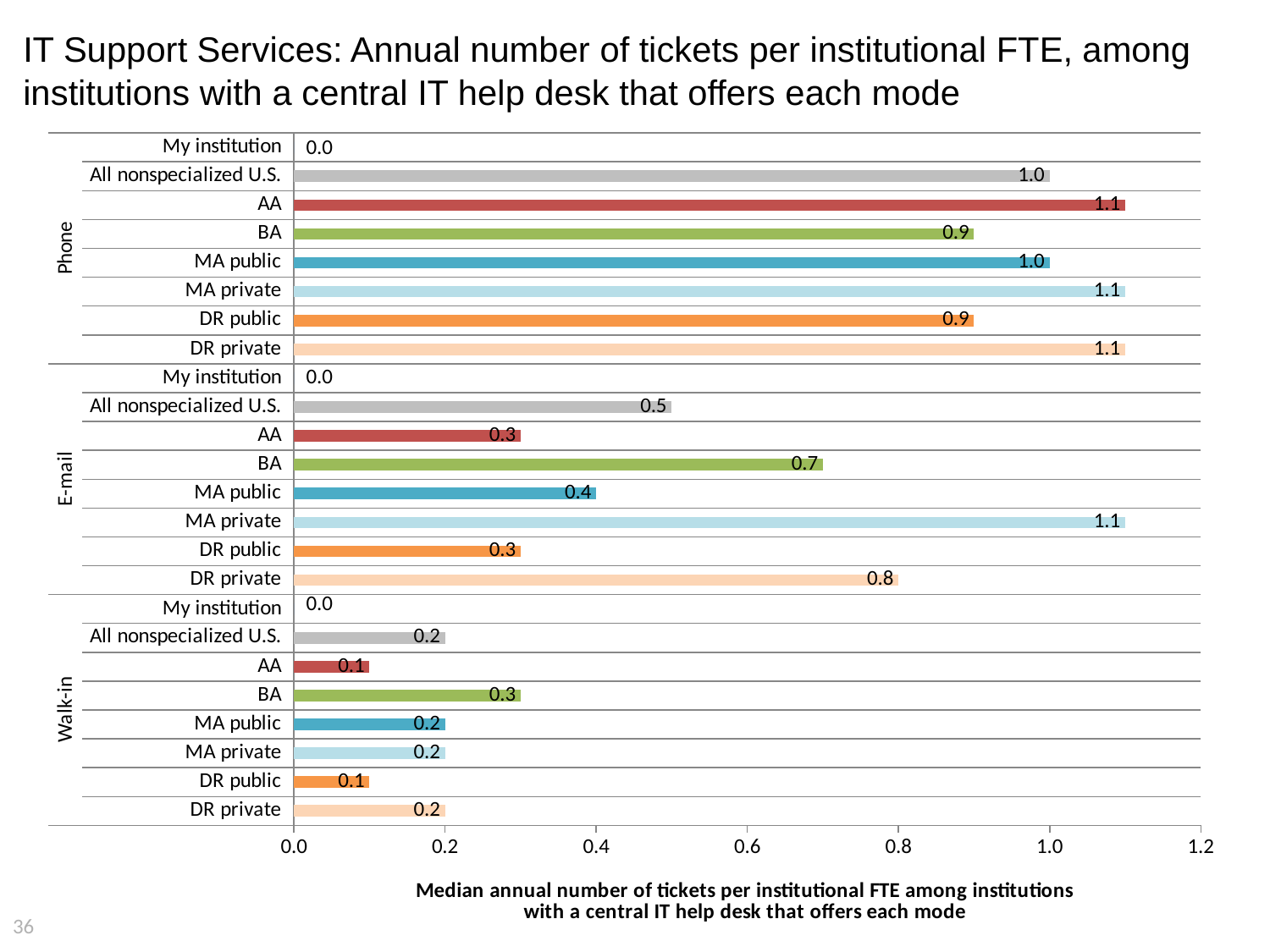
What is the value for MA private in the E-mail group? 1.1 How many mode groups (Phone, E-mail, Walk-in) are shown on the chart? 3 What is the difference between the MA private value in the Phone group and the MA private value in the Walk-in group? 0.9 What is the value for DR private in the E-mail group? 0.8 In the Phone group, which is larger: the value for AA or the value for BA? AA Within the Walk-in group, which category has the highest value? BA What is the difference between the BA value and the AA value in the E-mail group? 0.4 What kind of chart is shown on the slide? Bar chart Is the value for DR private in the Phone group greater or less than 1.0? greater What is the value for All nonspecialized U.S. in the Walk-in group? 0.2 What is the value for BA in the Phone group? 0.9 Within the E-mail group, which category has the highest value? MA private